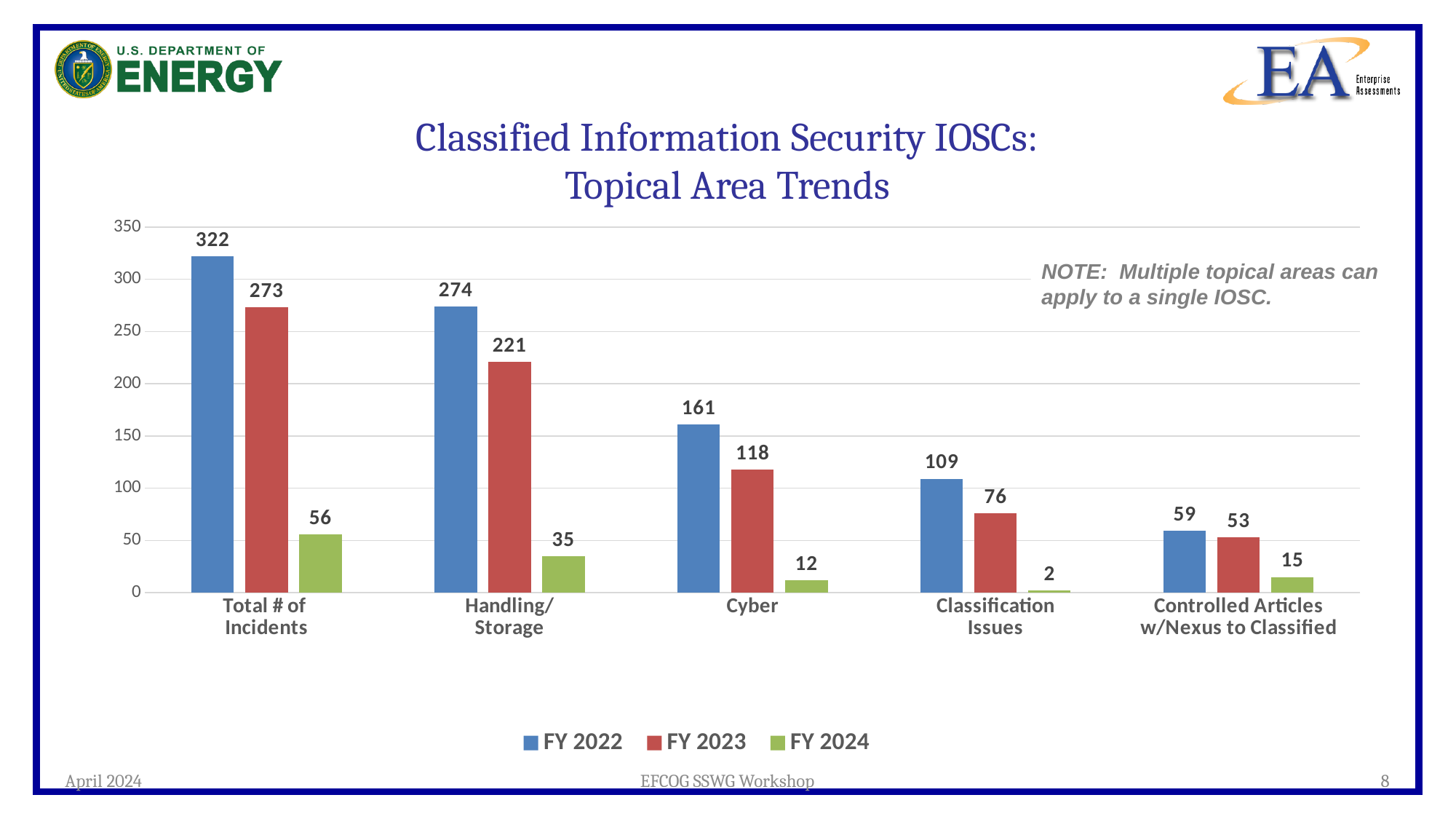
What is the FY 2023 value for Controlled Articles w/Nexus to Classified? 53 Which category has the highest FY 2023 value? Total # of Incidents What kind of chart is shown on the slide? Bar chart What is the difference between the FY 2022 and FY 2023 values for Total # of Incidents? 49 What is the difference between the FY 2022 and FY 2024 values for Cyber? 149 How many series does the legend list? 3 What is the FY 2024 value for Handling/Storage? 35 Which category has the lowest FY 2024 value? Classification Issues Which is larger: the FY 2023 value for Classification Issues or the FY 2022 value for Controlled Articles w/Nexus to Classified? FY 2023 value for Classification Issues What is the FY 2022 value for Cyber? 161 Across FY 2022, FY 2023 and FY 2024, do the values for Handling/Storage rise or fall? Fall How many categories are shown on the x axis? 5